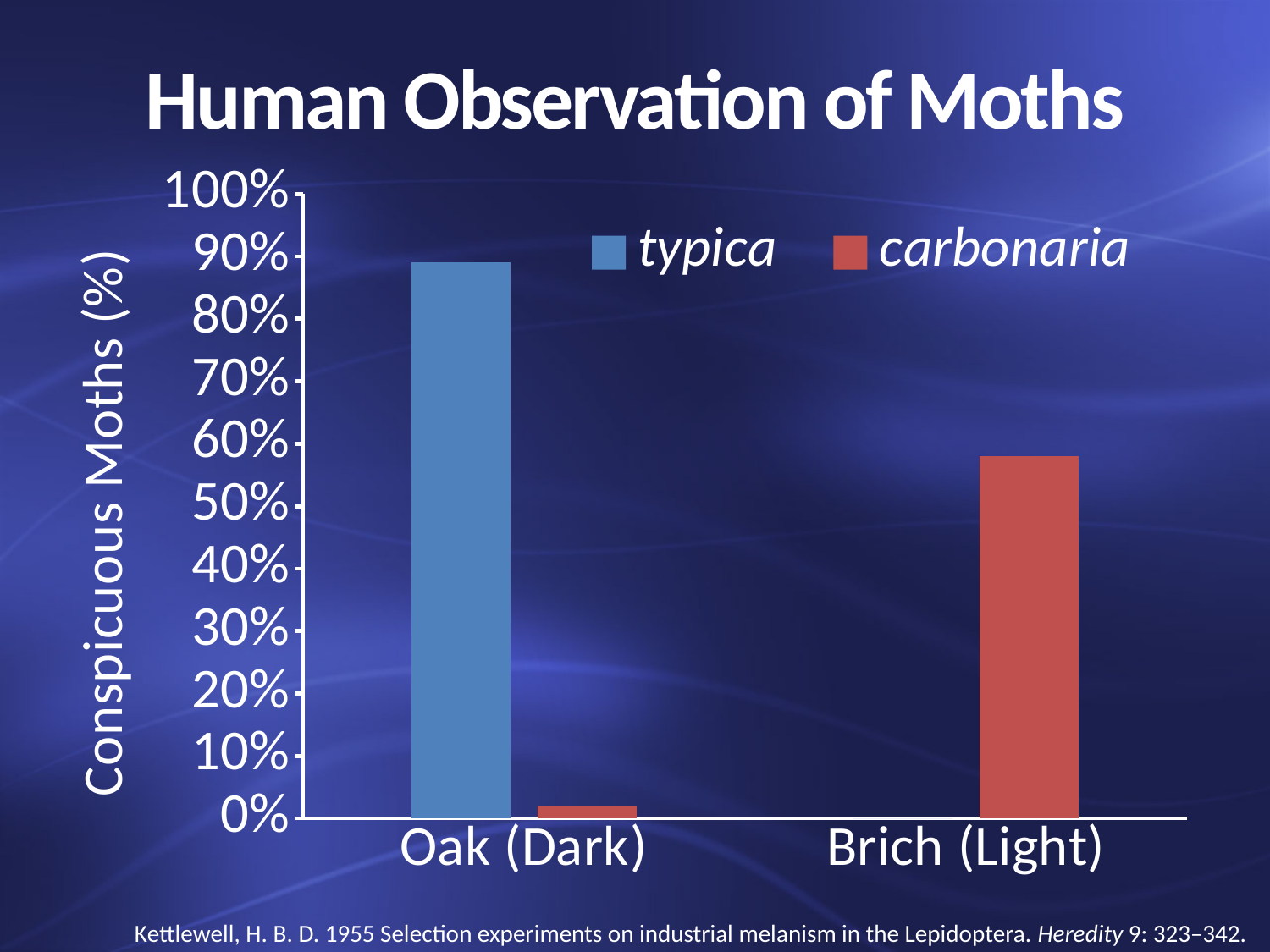
What is the title of the chart? Human Observation of Moths Which bar is the tallest in the chart? typica on Oak (Dark) Which is larger: typica on Oak (Dark) or carbonaria on Brich (Light)? typica on Oak (Dark) Is the value for carbonaria on Brich (Light) greater or less than 60%? less How many series does the legend list? 2 Is the value for carbonaria on Oak (Dark) greater or less than 10%? less How many categories are shown on the x axis? 2 What kind of chart is shown on the slide? bar chart What is the label of the y axis? Conspicuous Moths (%) Which series has the larger value for Oak (Dark), typica or carbonaria? typica Is the value for carbonaria on Brich (Light) greater or less than 50%? greater